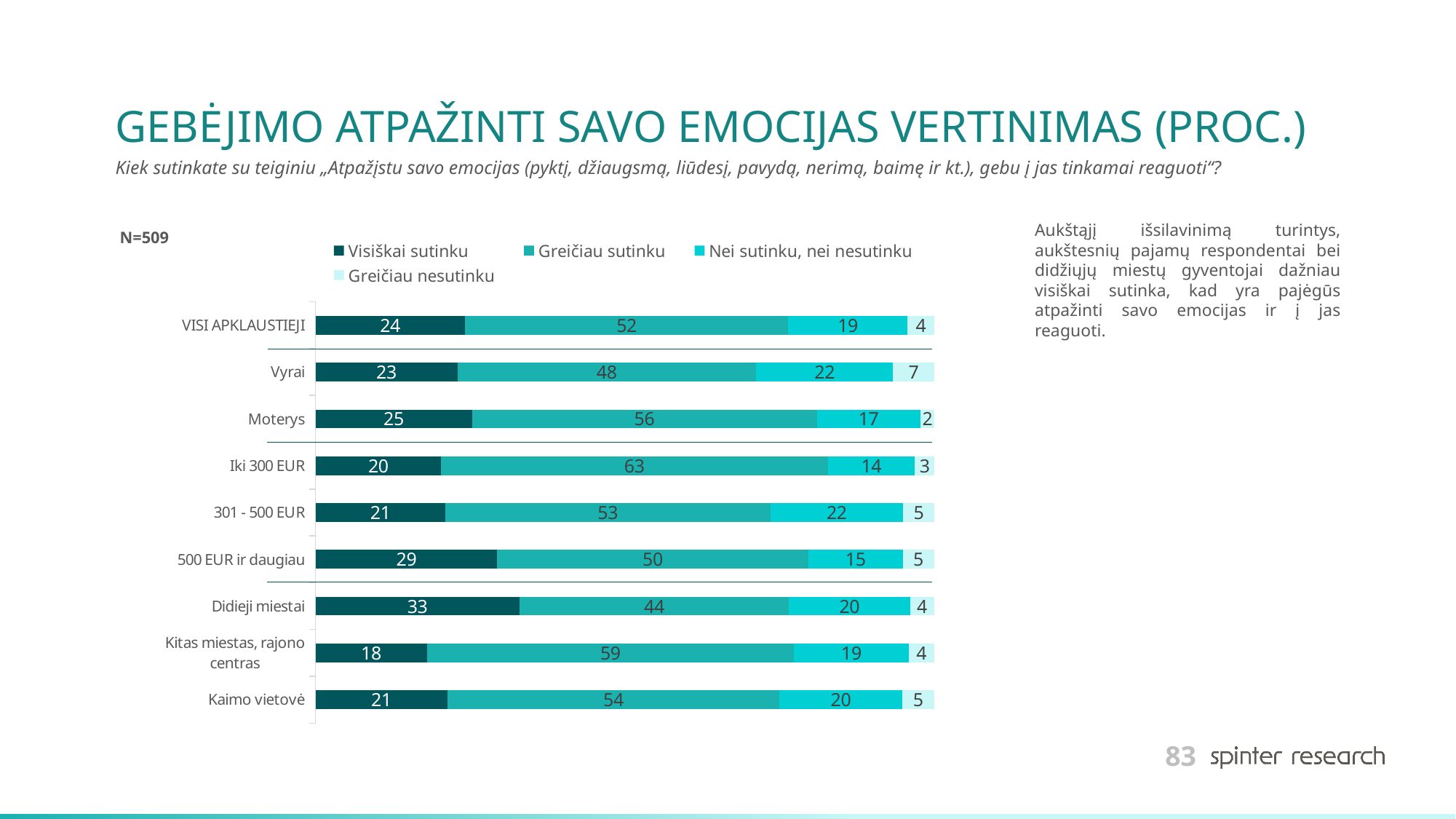
What is the value of "Greičiau nesutinku" for Moterys? 2 Which has a larger "Greičiau sutinku" value, Moterys or Vyrai? Moterys What is the value of "Greičiau sutinku" for Iki 300 EUR? 63 What is the value of "Visiškai sutinku" for Didieji miestai? 33 What kind of chart is shown on the slide? Stacked bar chart How many series does the legend list? 4 Which category has the highest value for "Visiškai sutinku"? Didieji miestai What is the value of "Nei sutinku, nei nesutinku" for Vyrai? 22 What is the difference between the "Visiškai sutinku" values for 500 EUR ir daugiau and Iki 300 EUR? 9 What is the total of the stacked bar for Vyrai? 100 Which category has the lowest value for "Visiškai sutinku"? Kitas miestas, rajono centras How many categories are shown on the chart? 9